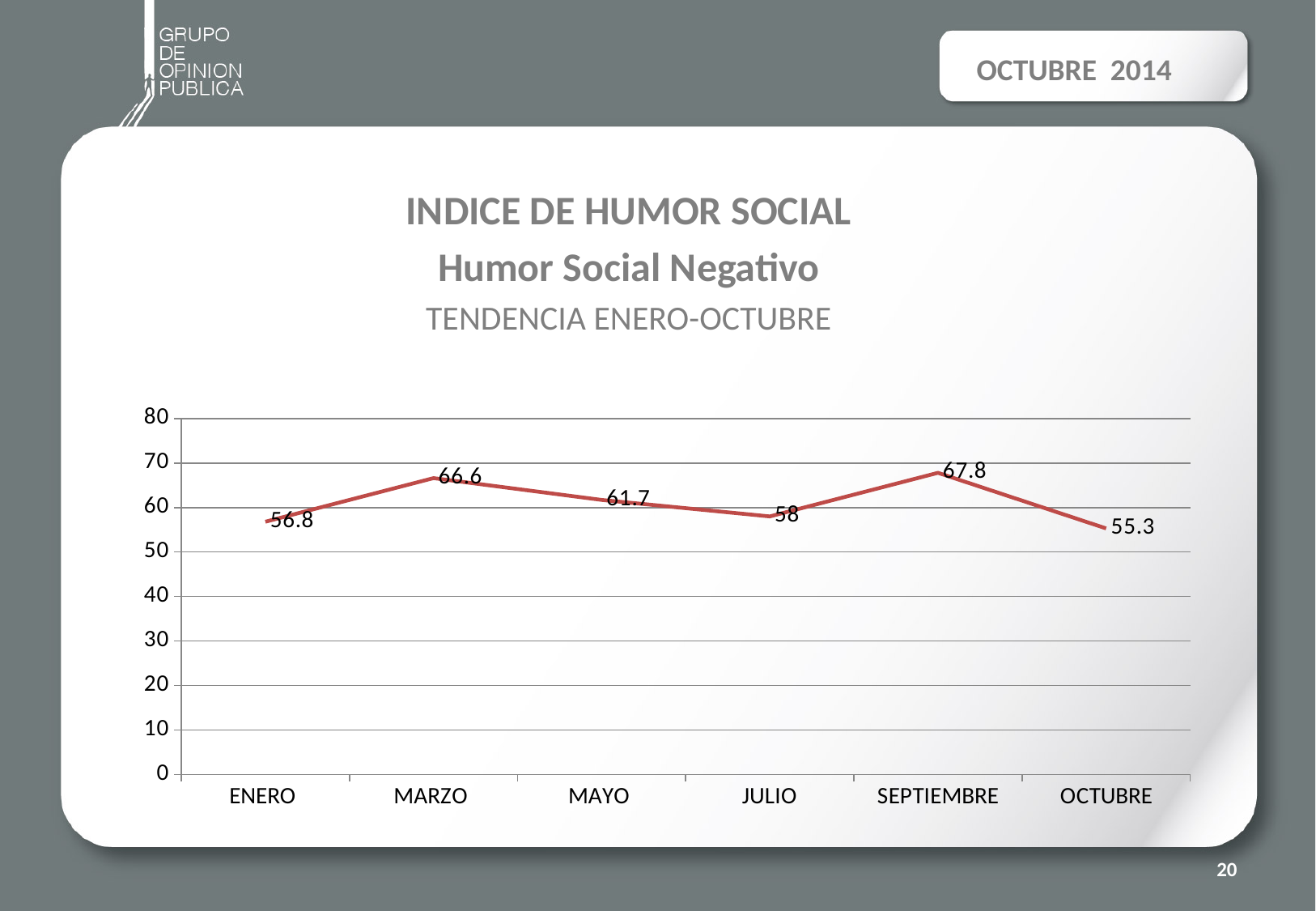
What is the value for MARZO? 66.6 What is the difference between the values for SEPTIEMBRE and OCTUBRE? 12.5 Is the value for MARZO greater or less than 60? greater What is the main title of the chart? INDICE DE HUMOR SOCIAL Which is larger, the value for ENERO or the value for MAYO? MAYO Which month has the lowest value? OCTUBRE Does the value rise or fall from SEPTIEMBRE to OCTUBRE? fall What kind of chart is shown? line chart What is the value for OCTUBRE? 55.3 How many months are plotted on the x axis? 6 What is the value for JULIO? 58 Which month has the highest value? SEPTIEMBRE